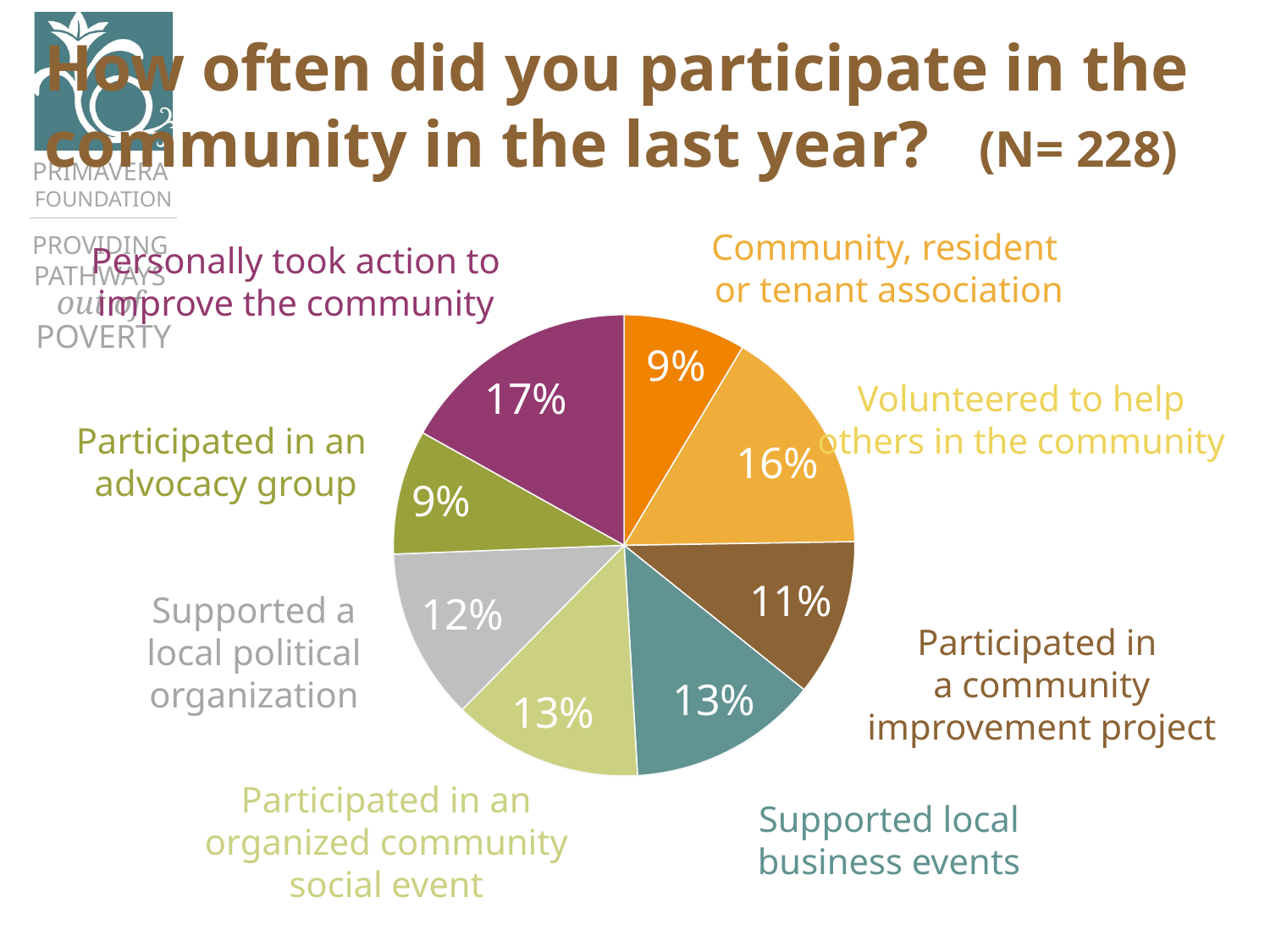
Which category has the largest slice of the pie? Personally took action to improve the community What is the sample size (N) stated in the slide title? 228 How many slices does the pie chart have? 8 What percentage is shown for 'Supported local business events'? 13% What percentage is shown for 'Supported a local political organization'? 12% What share of the pie is labelled 'Personally took action to improve the community'? 17% What percentage is shown for 'Volunteered to help others in the community'? 16% What is the difference in percentage points between 'Personally took action to improve the community' and 'Participated in an advocacy group'? 8 percentage points What percentage is shown for 'Participated in a community improvement project'? 11% What kind of chart is shown on the slide? pie chart What is the title of the chart on the slide? How often did you participate in the community in the last year? Which is larger: the slice for 'Volunteered to help others in the community' or the slice for 'Participated in a community improvement project'? Volunteered to help others in the community